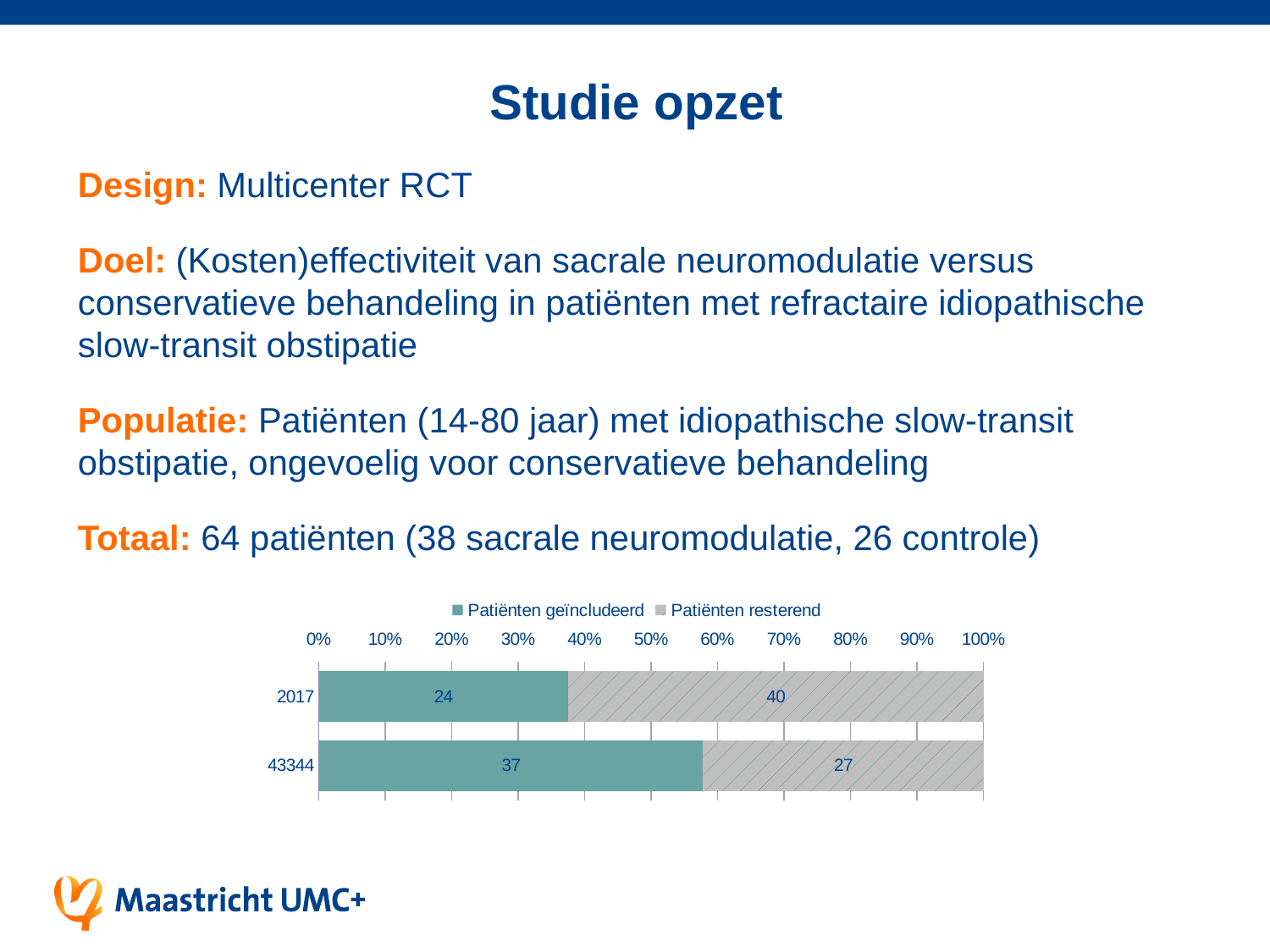
What is the value of 'Patiënten geïncludeerd' for the category 43344? 37 What are the two legend entries of the chart? Patiënten geïncludeerd, Patiënten resterend How many categories are shown on the chart's vertical axis? 2 What is the value of 'Patiënten resterend' for the category 43344? 27 What kind of chart is shown on the slide? Stacked bar chart What is the difference between 'Patiënten geïncludeerd' for 43344 and for 2017? 13 Which category has the higher value for 'Patiënten geïncludeerd', 2017 or 43344? 43344 Which category has the lowest value for 'Patiënten resterend'? 43344 What is the value of 'Patiënten geïncludeerd' for 2017? 24 What is the value of 'Patiënten resterend' for 2017? 40 How many series does the chart legend list? 2 What is the total of the two segments in the 2017 bar? 64